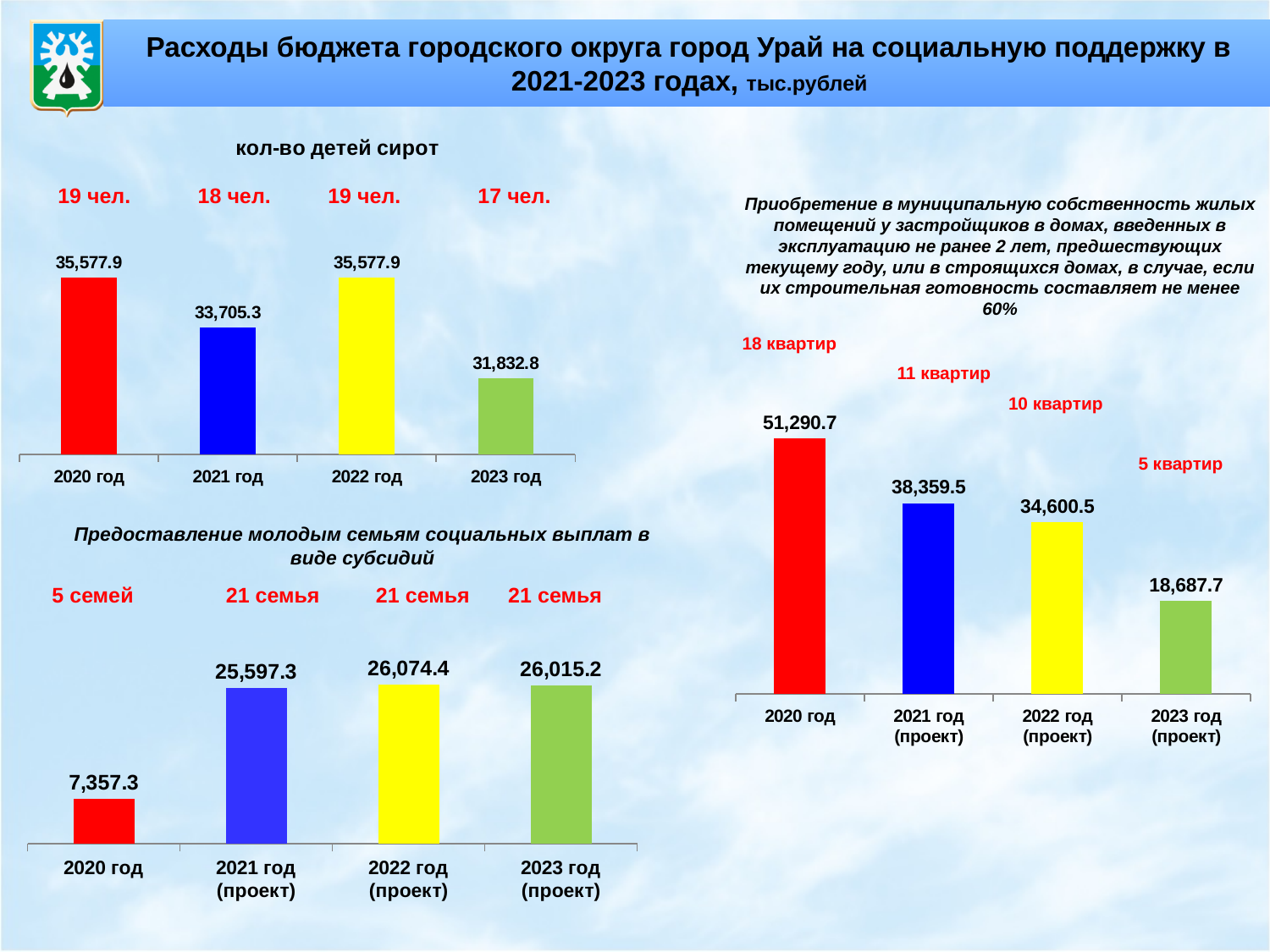
In the bottom-left chart (Предоставление молодым семьям социальных выплат в виде субсидий), what is the value for 2020 год? 7,357.3 In the right chart (Приобретение в муниципальную собственность жилых помещений), what is the value for 2022 год (проект)? 34,600.5 What type of chart is the top-left chart (кол-во детей сирот)? bar chart In the right chart (Приобретение в муниципальную собственность жилых помещений), how many apartments (квартир) are indicated for 2021 год (проект)? 11 квартир In the top-left chart (кол-во детей сирот), how many children (чел.) are shown above the 2023 год bar? 17 чел. In the top-left chart (кол-во детей сирот), what is the value for 2021 год? 33,705.3 In the bottom-left chart (Предоставление молодым семьям социальных выплат в виде субсидий), which year has the highest value? 2022 год (проект) In the bottom-left chart (Предоставление молодым семьям социальных выплат в виде субсидий), how many bars are plotted? 4 In the top-left chart (кол-во детей сирот), what is the difference between the 2020 год and 2023 год values? 3,745.1 In the right chart (Приобретение в муниципальную собственность жилых помещений), what is the difference between the 2020 год and 2021 год (проект) values? 12,931.2 In the top-left chart (кол-во детей сирот), which year has the lowest value? 2023 год In the right chart (Приобретение в муниципальную собственность жилых помещений), do the values rise or fall from 2020 год to 2023 год (проект)? fall